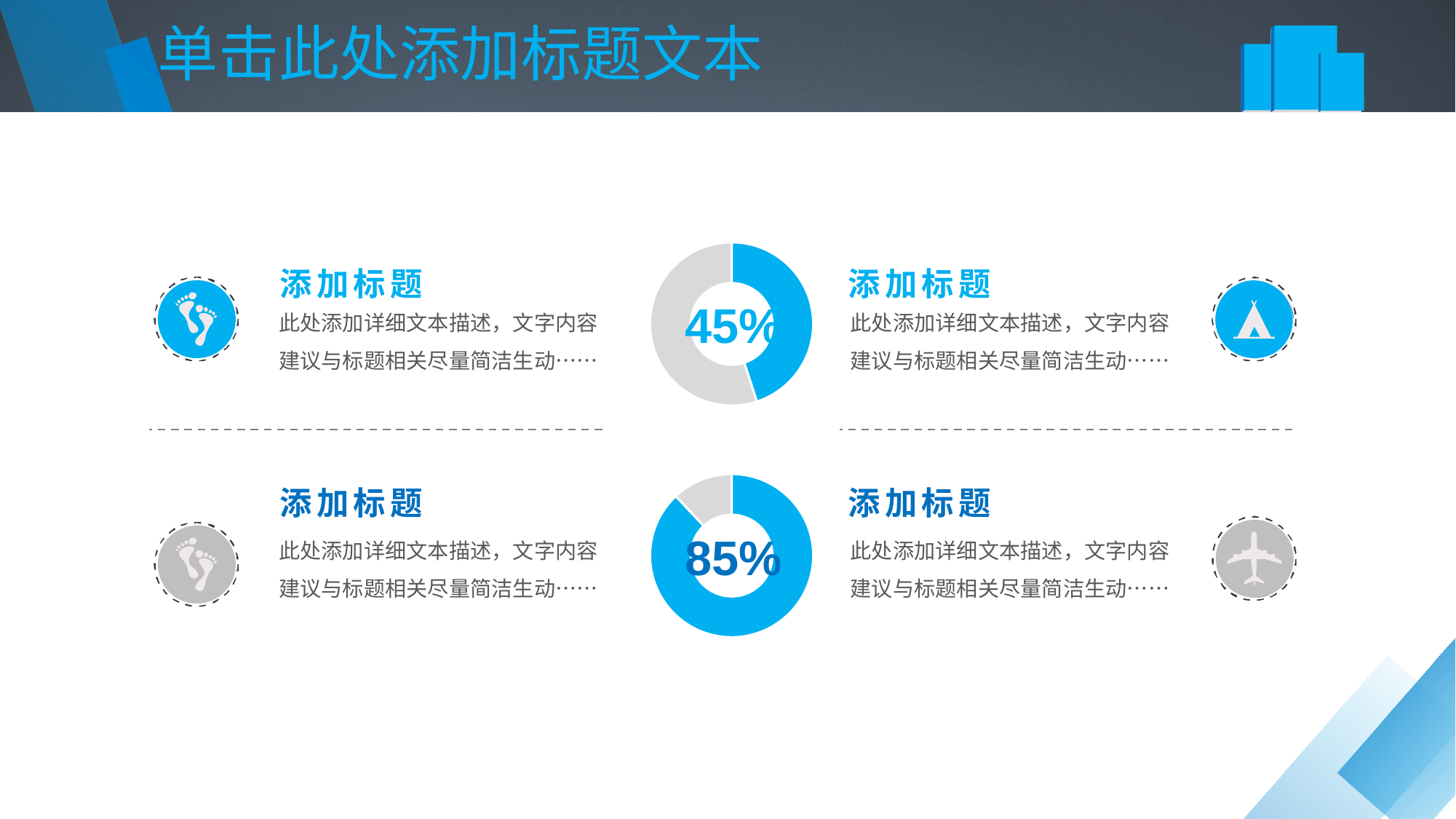
What is the difference in percentage points between the lower donut chart (85%) and the upper donut chart (45%)? 40 In the lower donut chart, is the blue segment greater or less than 50% of the ring? greater Which donut chart shows the larger percentage, the upper one or the lower one? The lower one What kind of chart is the upper chart showing 45%? Donut chart What percentage is shown in the centre of the lower donut chart? 85% How many donut charts are on the slide? 2 Which donut chart shows the smaller percentage, the upper one or the lower one? The upper one What kind of chart is the lower chart showing 85%? Donut chart What percentage is shown in the centre of the upper donut chart? 45% What colour is the filled (highlighted) segment in both donut charts? Blue In the upper donut chart, is the blue segment greater or less than 50% of the ring? less What colour is the remaining (unfilled) segment in both donut charts? Grey